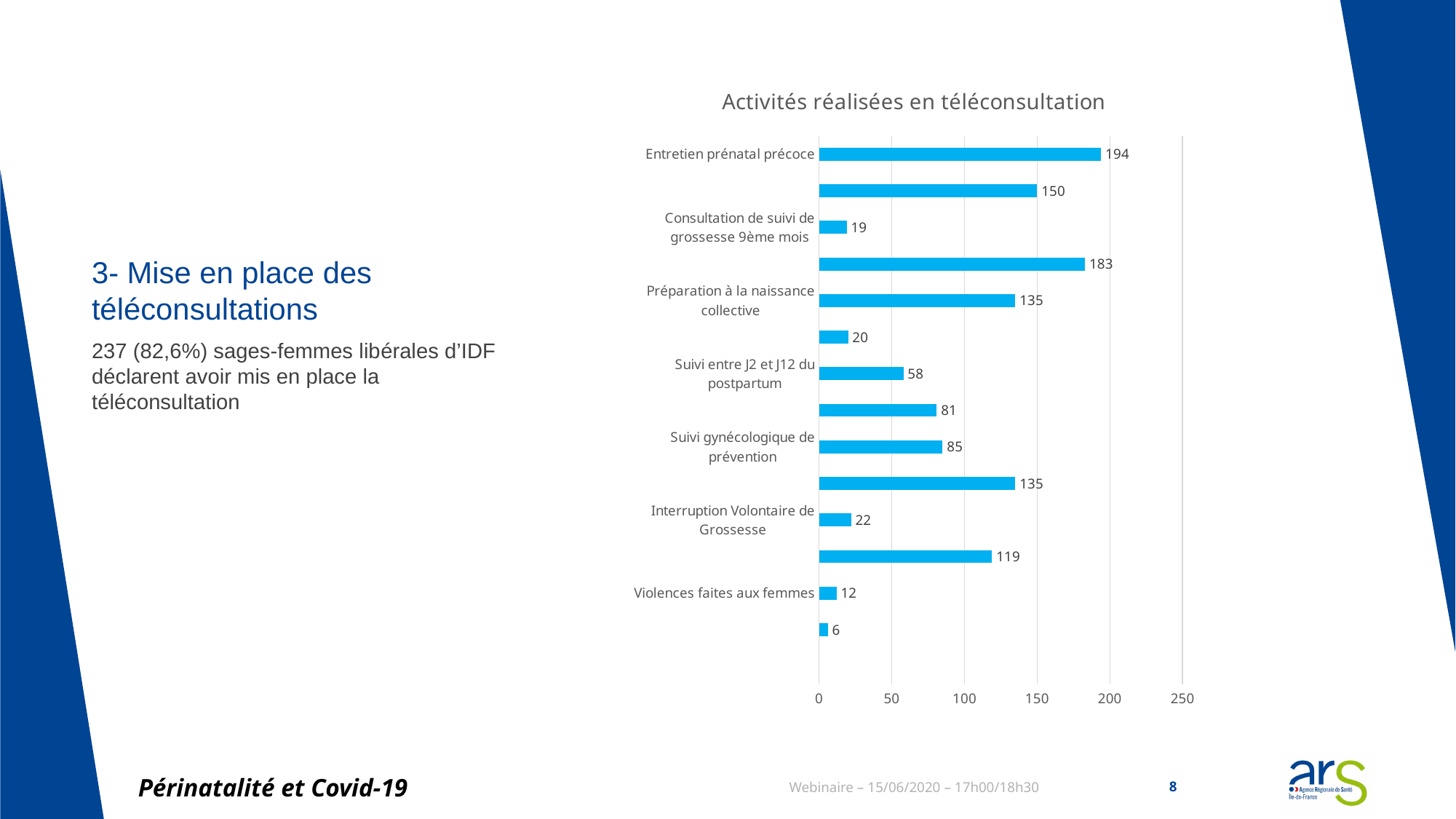
What is the value for Entretien prénatal précoce? 194 What is the value for Suivi entre J2 et J12 du postpartum? 58 What is the value for Consultation de suivi de grossesse 9ème mois? 19 What is the difference between the values for Entretien prénatal précoce and Préparation à la naissance collective? 59 Which is larger, the value for Suivi gynécologique de prévention or the value for Interruption Volontaire de Grossesse? Suivi gynécologique de prévention What is the value for Violences faites aux femmes? 12 What is the smallest value printed on the chart? 6 What is the title of the chart? Activités réalisées en téléconsultation What type of chart is shown on the slide? bar chart Which labelled category has the highest value? Entretien prénatal précoce What is the value for Préparation à la naissance collective? 135 How many bars are plotted on the chart? 14